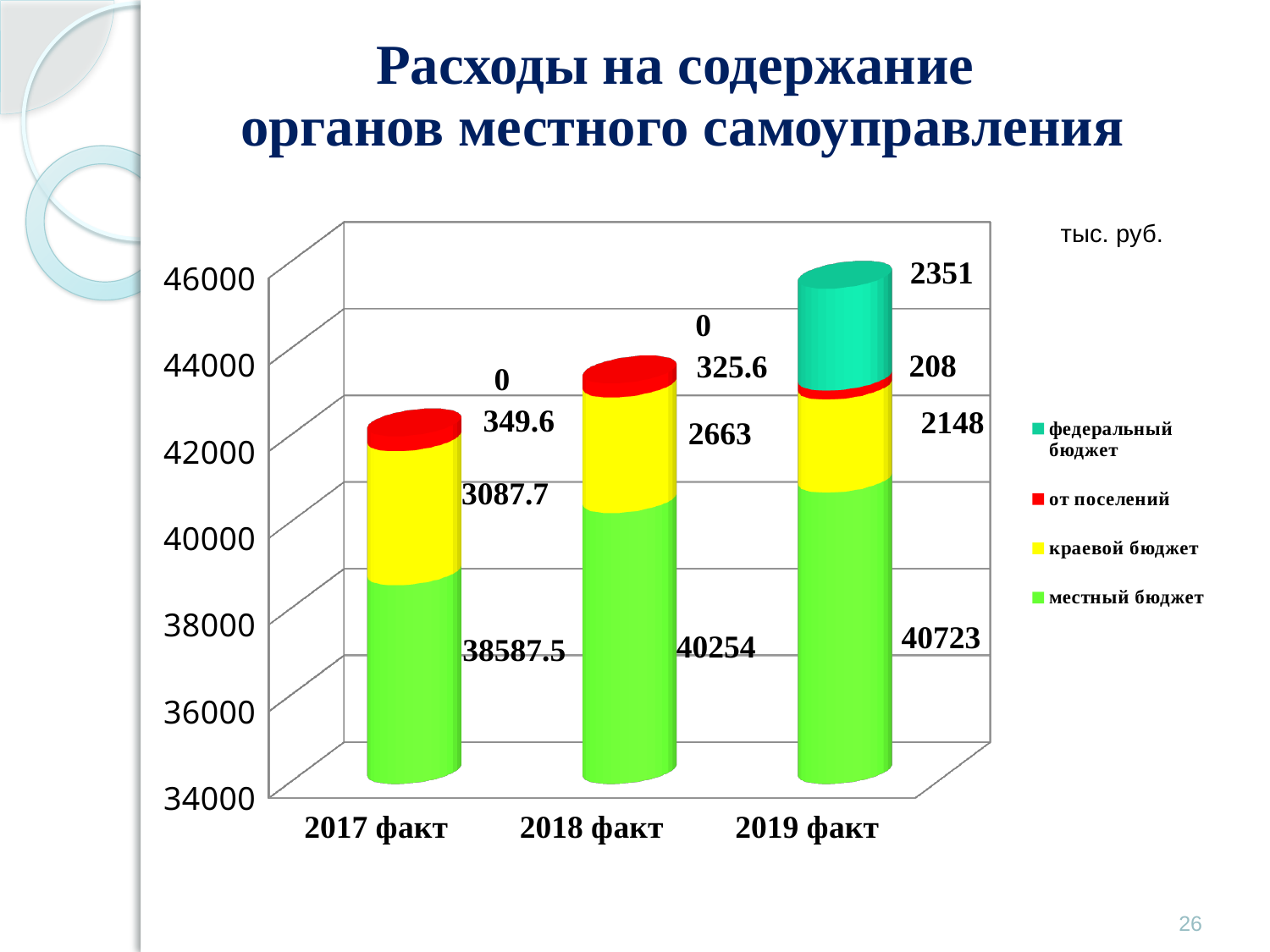
What is the value of краевой бюджет for 2018 факт? 2663 What is the total of the stacked bar for 2019 факт? 45430 What is the value of от поселений for 2019 факт? 208 What is the value of федеральный бюджет for 2019 факт? 2351 Does местный бюджет rise or fall from 2017 факт to 2019 факт? rise In which year is местный бюджет the highest? 2019 факт In which year is краевой бюджет the lowest? 2019 факт How many categories are shown on the x axis? 3 How many series does the legend list? 4 What type of chart is shown on the slide? stacked bar chart What is the difference between местный бюджет in 2018 факт and 2017 факт? 1666.5 What is the value of местный бюджет for 2017 факт? 38587.5